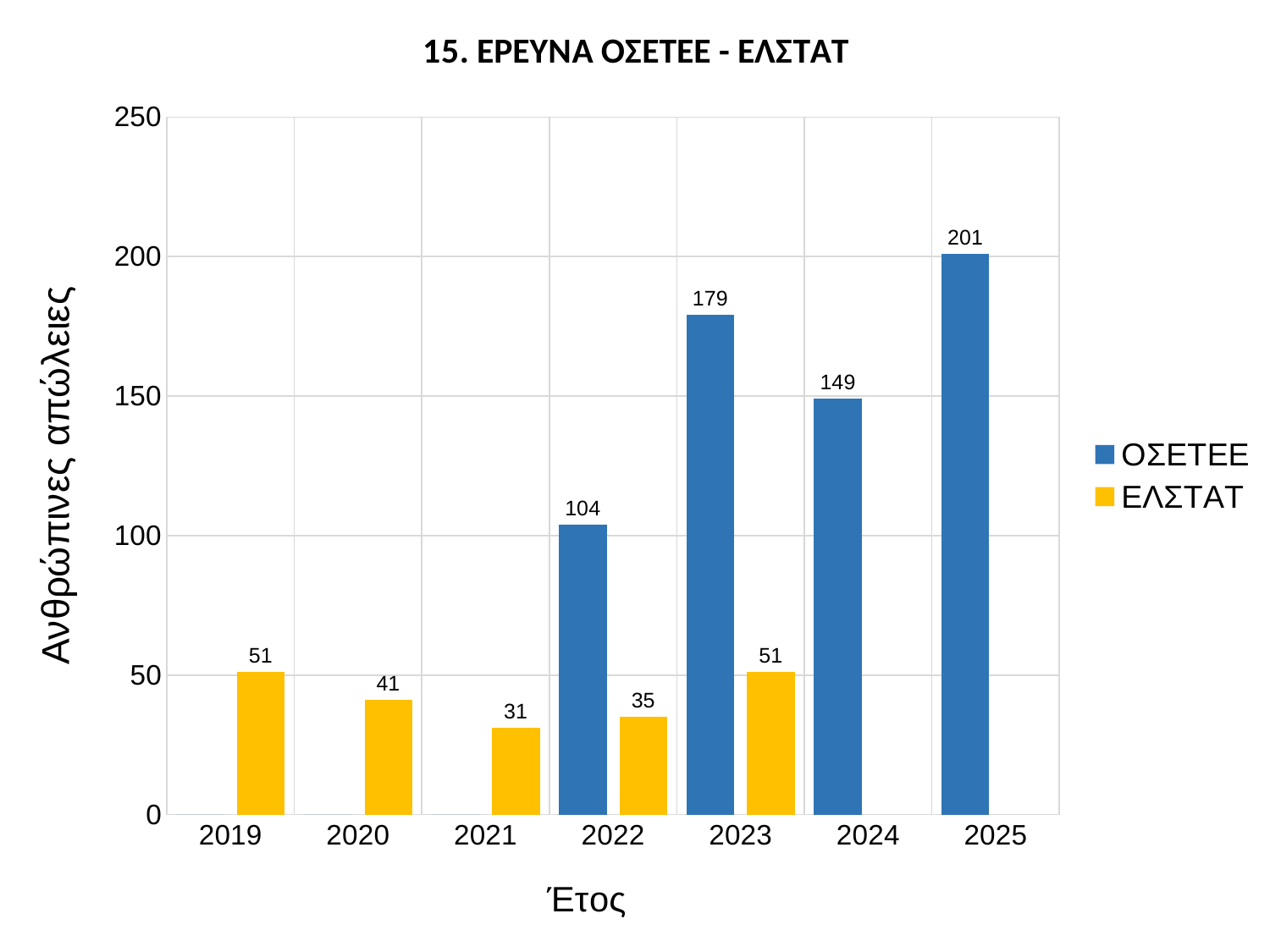
What is the ΕΛΣΤΑΤ value for 2021? 31 How many years are shown on the x axis? 7 What kind of chart is shown? bar chart Which year has the lowest ΕΛΣΤΑΤ value? 2021 Is the ΟΣΕΤΕΕ value for 2024 greater or less than 100? greater What is the difference between the ΟΣΕΤΕΕ and ΕΛΣΤΑΤ values for 2023? 128 Which is larger, the ΟΣΕΤΕΕ value for 2023 or for 2024? 2023 What is the ΟΣΕΤΕΕ value for 2025? 201 What is the title of the chart? 15. ΕΡΕΥΝΑ ΟΣΕΤΕΕ - ΕΛΣΤΑΤ What is the ΟΣΕΤΕΕ value for 2022? 104 How many series does the legend list? 2 Which year has the highest ΟΣΕΤΕΕ value? 2025